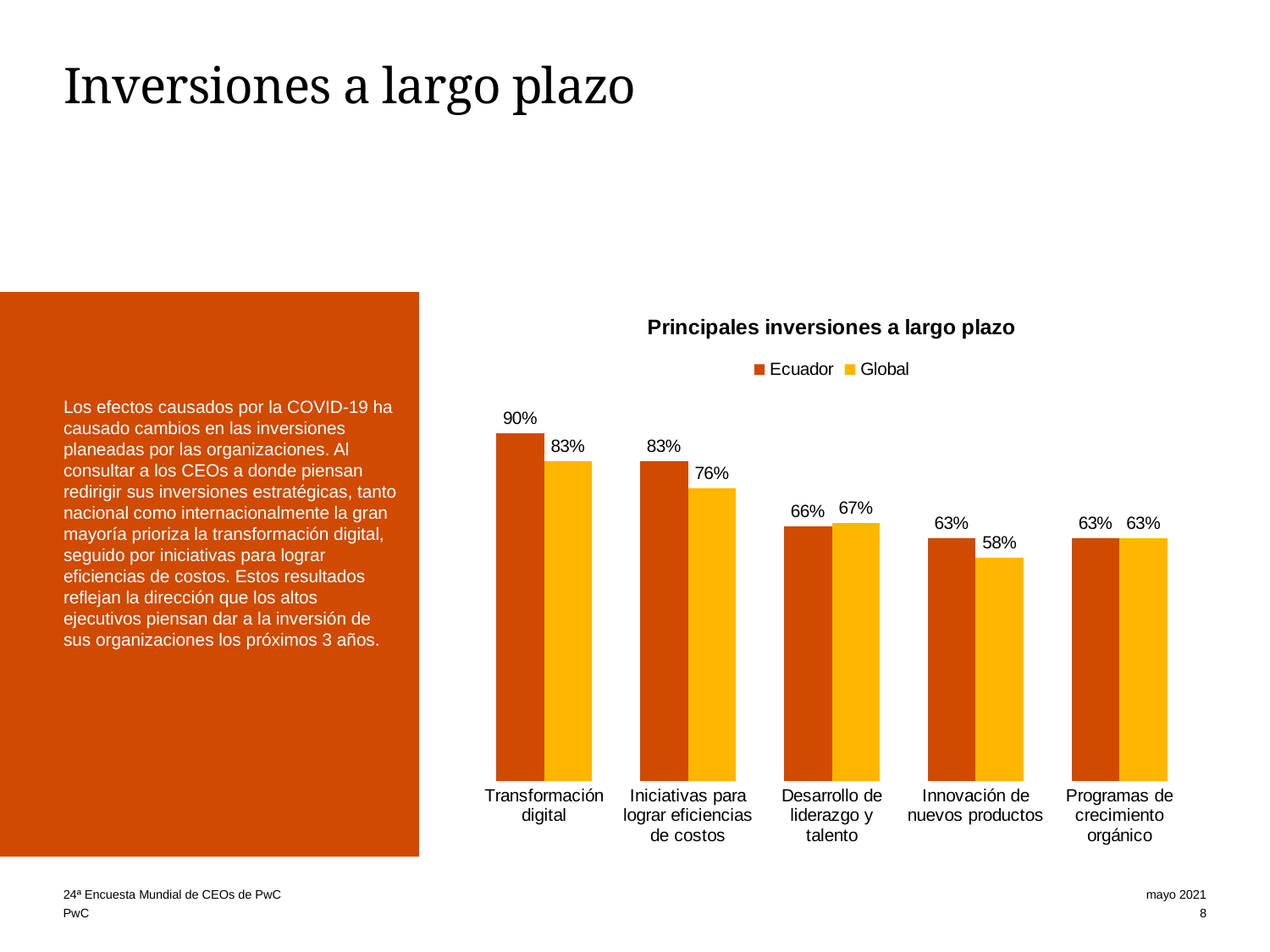
How many categories are shown on the x axis? 5 What is the title of the chart? Principales inversiones a largo plazo What is the Global value for Iniciativas para lograr eficiencias de costos? 76% Do the Ecuador values rise or fall from Transformación digital to Innovación de nuevos productos? Fall What is the difference between the Ecuador and Global values for Transformación digital? 7% What is the Global value for Innovación de nuevos productos? 58% What is the Ecuador value for Transformación digital? 90% Which is larger for Desarrollo de liderazgo y talento, the Ecuador value or the Global value? Global Which category has the lowest Global value? Innovación de nuevos productos How many series does the legend list? 2 What kind of chart is shown? Bar chart Which category has the highest Ecuador value? Transformación digital